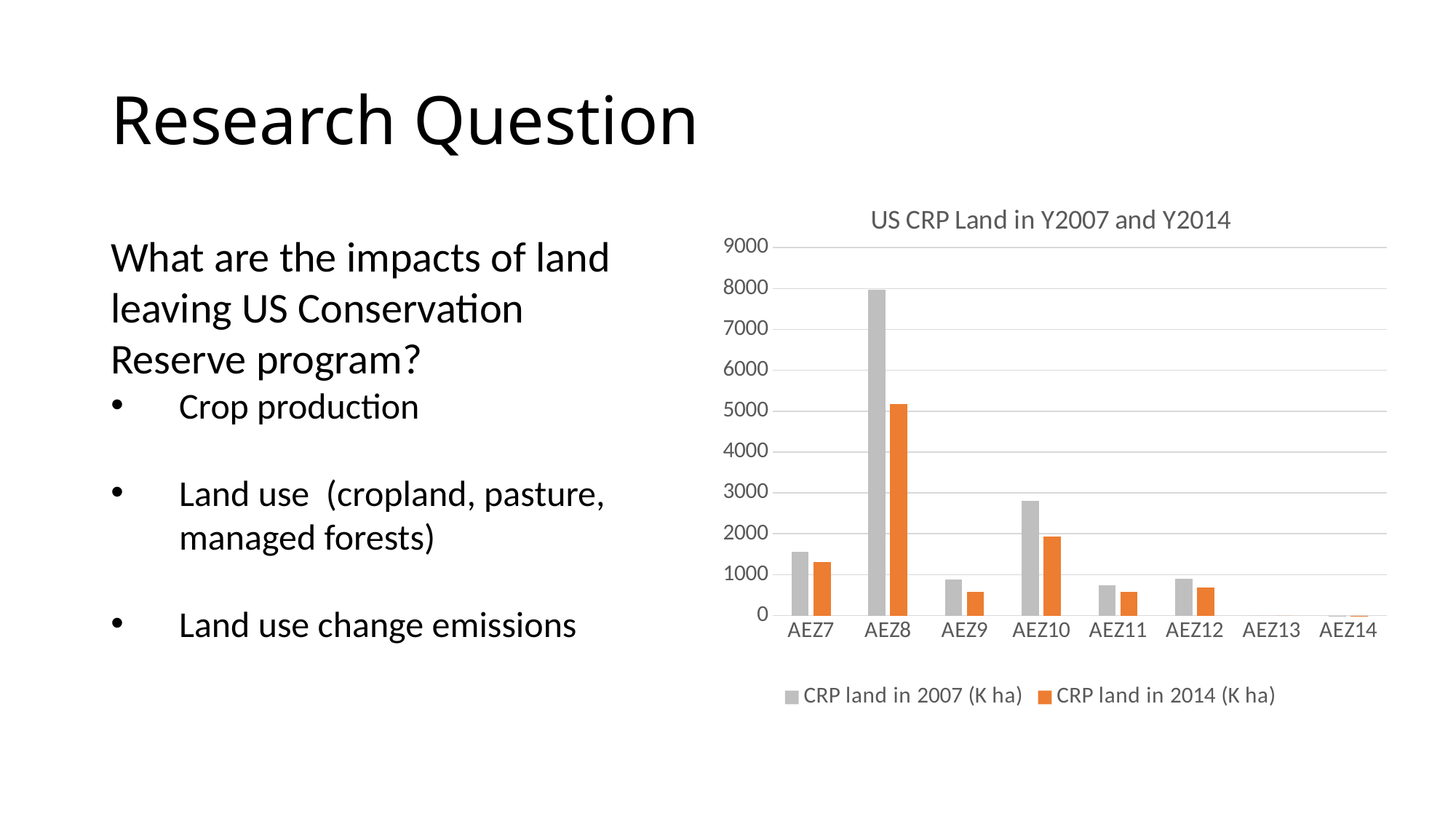
Is the value of CRP land in 2007 (K ha) for AEZ10 greater or less than 3000? less Is the value of CRP land in 2014 (K ha) for AEZ8 greater or less than 5000? greater Is the value of CRP land in 2007 (K ha) for AEZ9 greater or less than 1000? less Which colour represents the CRP land in 2014 (K ha) series? Orange Which AEZ has the highest CRP land in 2014 (K ha)? AEZ8 What is the title of the chart? US CRP Land in Y2007 and Y2014 Which AEZ has the highest CRP land in 2007 (K ha)? AEZ8 How many series does the chart legend list? 2 How many AEZ categories are shown on the x axis? 8 For AEZ7, which is larger: CRP land in 2007 (K ha) or CRP land in 2014 (K ha)? CRP land in 2007 (K ha) What type of chart is shown on the slide? Bar chart